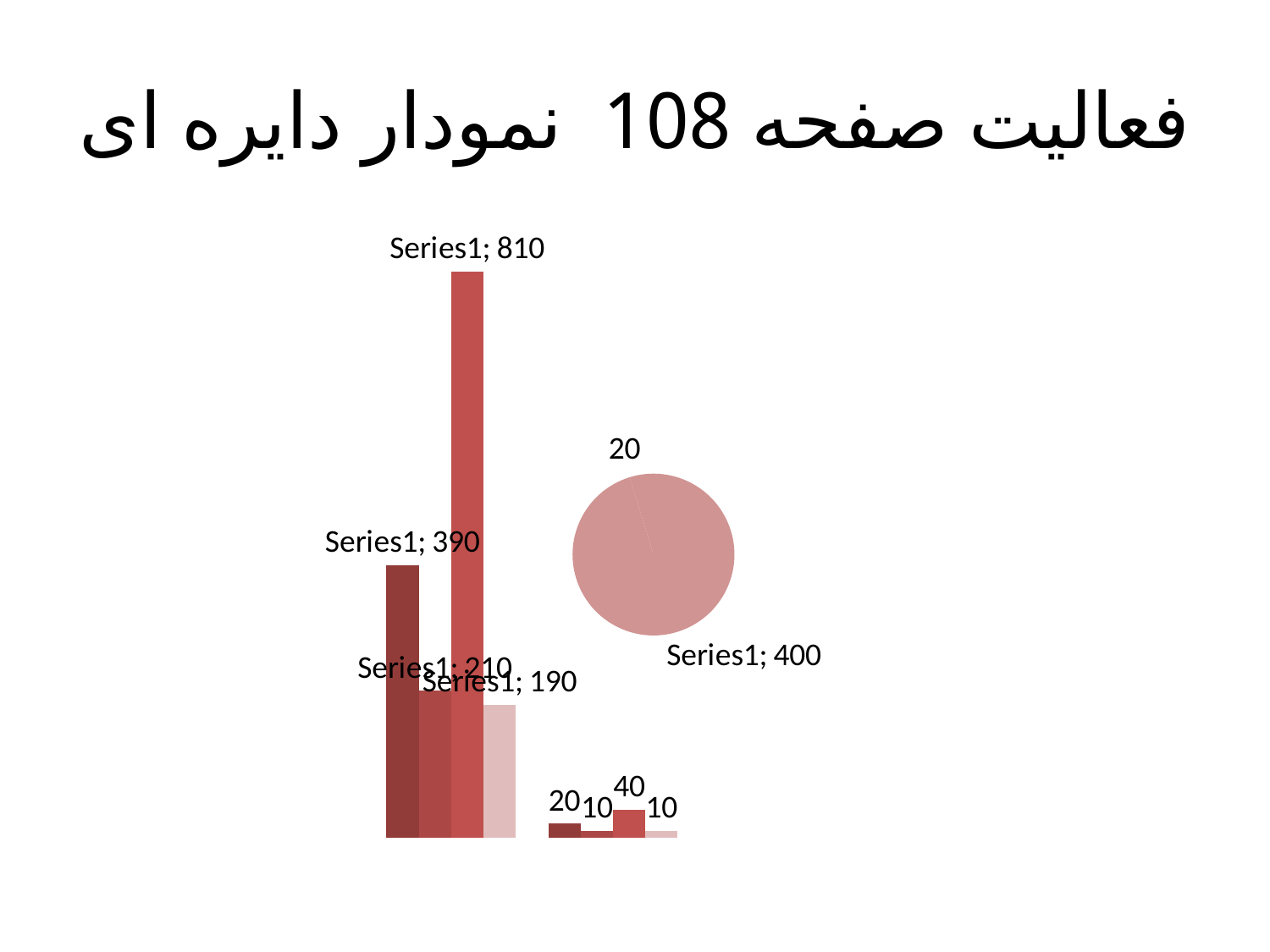
What kind of chart is the chart on the right of the slide? pie chart In the bar chart on the left, what is the difference between the bar labeled 210 and the bar labeled 190? 20 In the bar chart on the left, how many bars are in the small group of bars at the bottom right? 4 What kind of chart is the chart on the left of the slide? bar chart In the bar chart on the left, what is the difference between the bar labeled 810 and the bar labeled 390? 420 In the bar chart on the left, what is the highest labeled value? 810 In the bar chart on the left, how many bars are in the tall group of bars? 4 In the pie chart on the right, what is the value of the larger slice? 400 What series name appears in the data labels of the bar chart on the left? Series1 In the bar chart on the left, which is larger: the bar labeled 390 or the bar labeled 210? 390 In the pie chart on the right, what is the total of the two slice values? 420 In the bar chart on the left, what is the lowest labeled value? 10